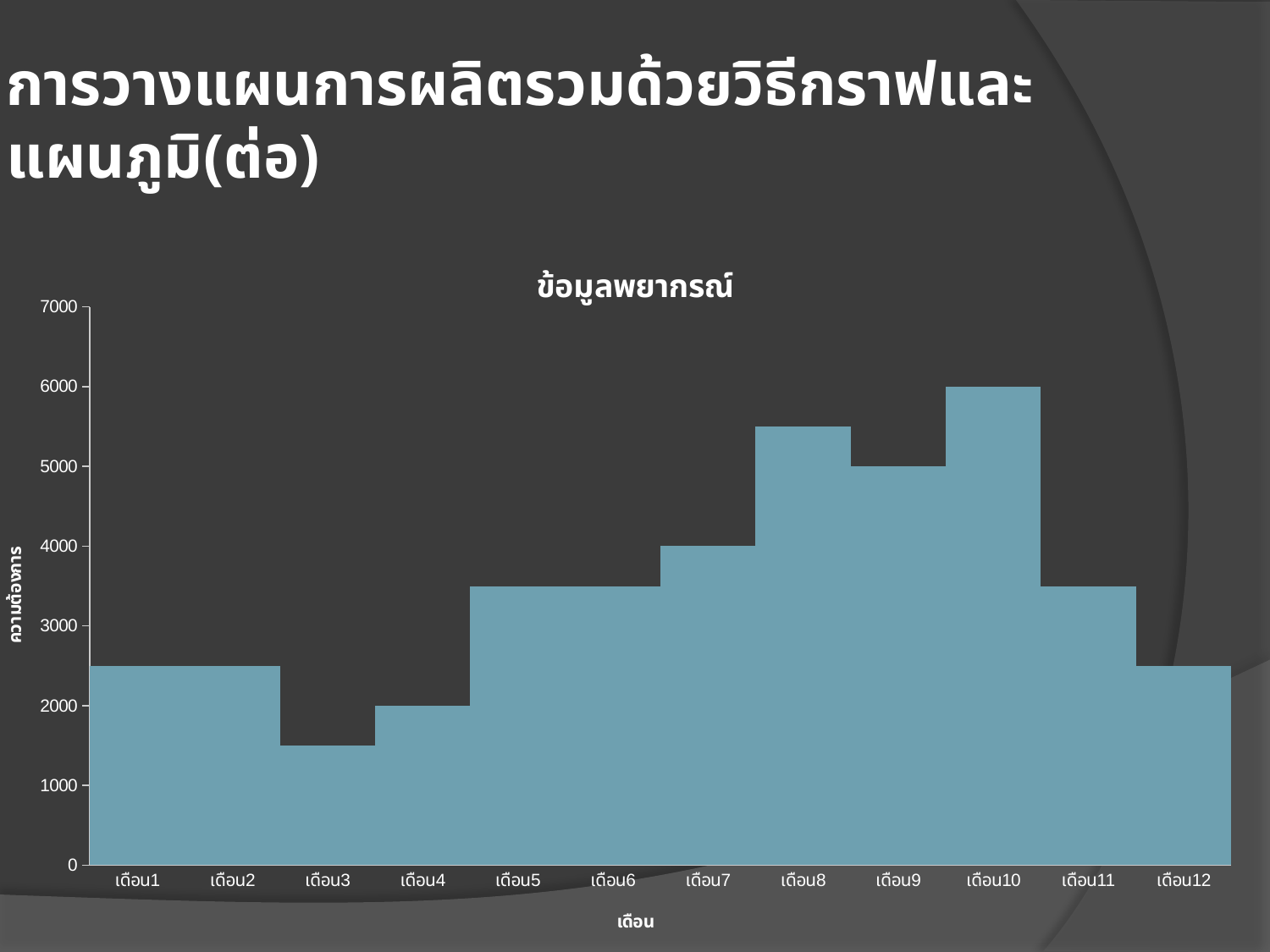
What kind of chart is shown on the slide? bar chart Which month has the highest value? เดือน10 What is the value for เดือน4? 2000 What is the value for เดือน7? 4000 What is the difference between the values for เดือน10 and เดือน9? 1000 Which is larger, the value for เดือน8 or the value for เดือน9? เดือน8 What is the value for เดือน9? 5000 What is the title of the chart? ข้อมูลพยากรณ์ What is the value for เดือน10? 6000 Is the value for เดือน8 greater or less than 5000? greater How many months (categories) are shown on the x axis? 12 Which month has the lowest value? เดือน3